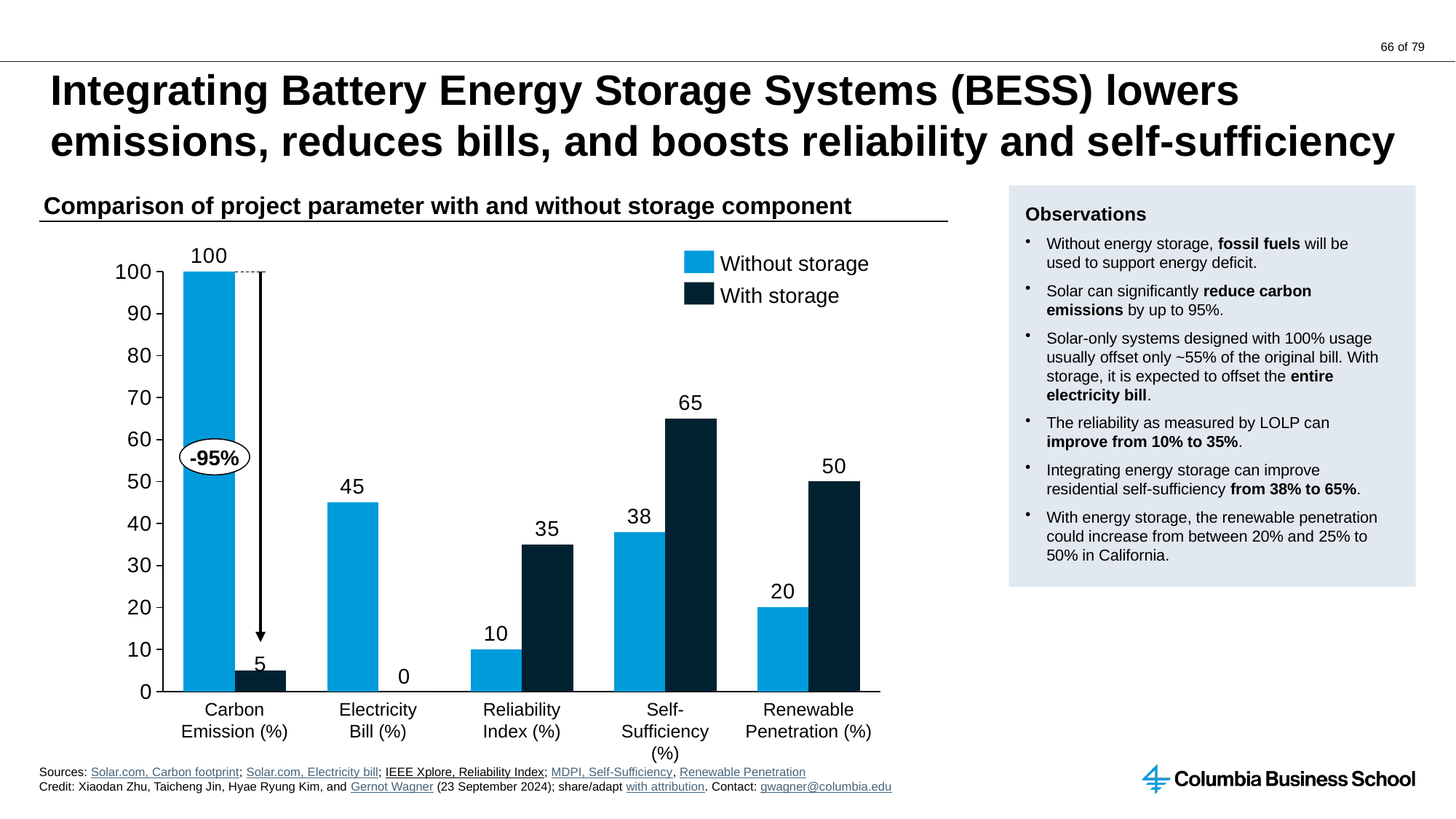
What is the value for Reliability Index (%) with storage? 35 Which category has the lowest value in the Without storage series? Reliability Index (%) What is the difference between the with storage and without storage values for Renewable Penetration (%)? 30 What is the value for Carbon Emission (%) with storage? 5 What is the value for Self-Sufficiency (%) without storage? 38 How many series does the legend list? 2 What is the value for Electricity Bill (%) with storage? 0 How many categories are shown on the x axis? 5 What is the value for Carbon Emission (%) without storage? 100 What kind of chart is shown on the slide? Bar chart Which category has the highest value in the With storage series? Self-Sufficiency (%) Which is larger for Electricity Bill (%): the value without storage or with storage? Without storage